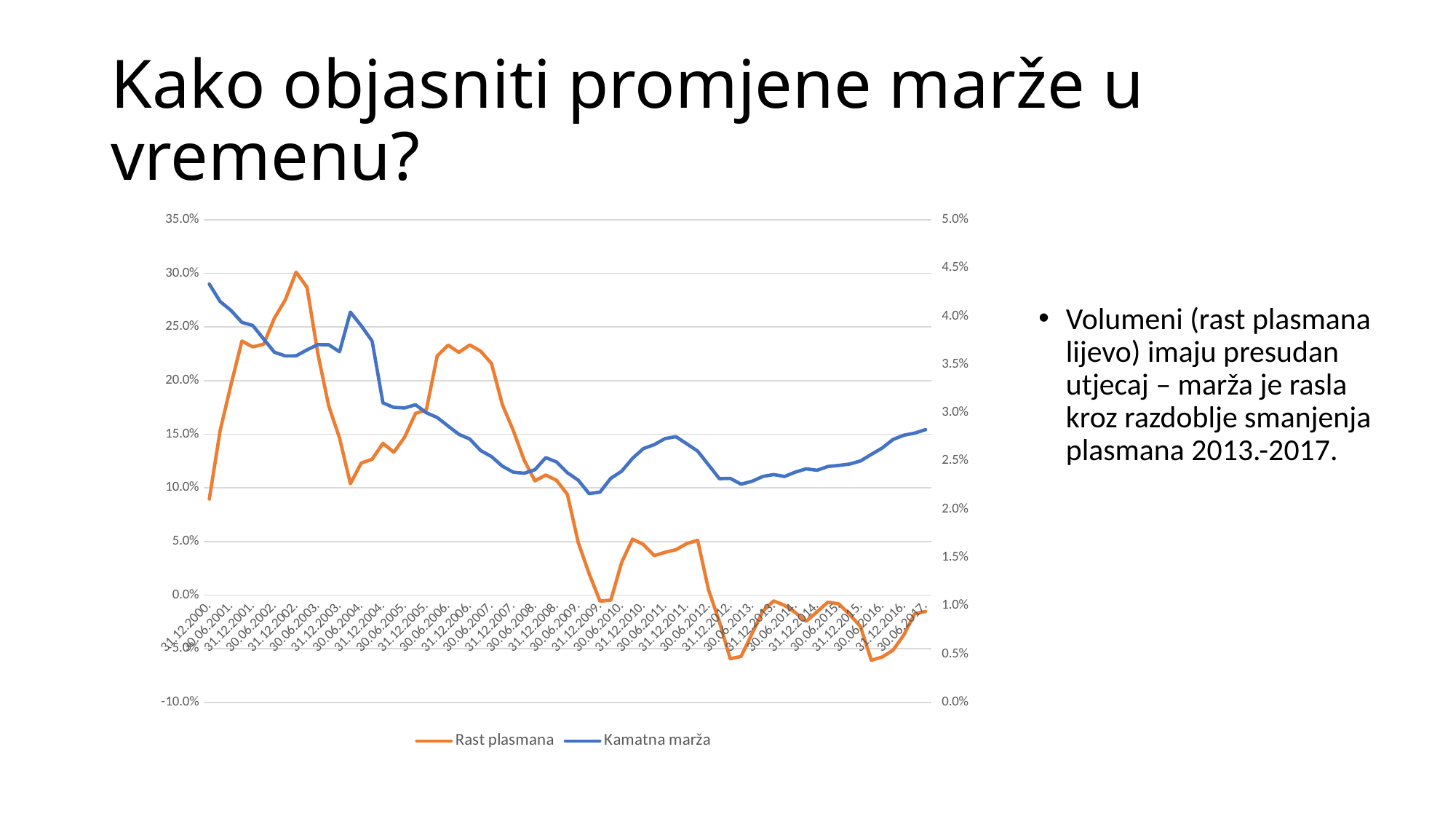
What are the two series named in the chart legend? Rast plasmana and Kamatna marža How many series does the chart legend list? 2 Is the value for Rast plasmana at 31.12.2000. greater or less than 5.0% on the left axis? greater Which is larger for Rast plasmana: the value at 31.12.2000. or the value at 30.06.2001.? 30.06.2001. At which date does Kamatna marža reach its highest value? 31.12.2000. How many dates are labelled along the x axis of the chart? 34 Is the value for Kamatna marža at 31.12.2000. greater or less than 4.0% on the right axis? greater What kind of chart is shown on the slide? line chart Is the value for Kamatna marža at 30.06.2017. greater or less than 3.0% on the right axis? less Does Kamatna marža rise or fall between 30.06.2013. and 30.06.2017.? rise What colour is the line for Kamatna marža? blue